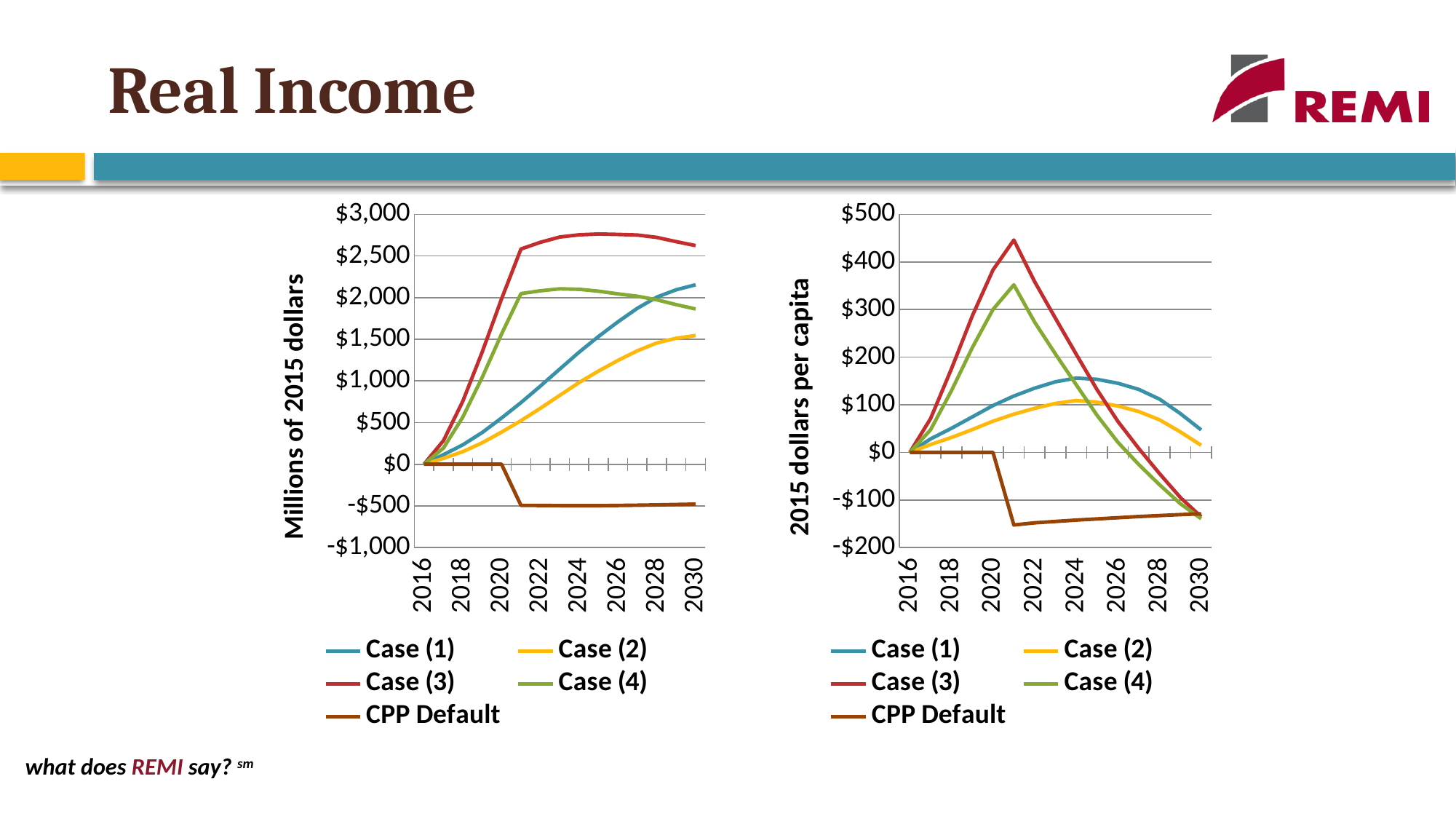
In the right chart (2015 dollars per capita), does Case (3) rise or fall from 2021 to 2030? Falls In the left chart (Millions of 2015 dollars), does Case (1) rise or fall from 2016 to 2030? Rises In the left chart (Millions of 2015 dollars), which series has the highest value in 2025? Case (3) What kind of chart is the left chart (Millions of 2015 dollars)? Line chart How many series does the legend of the right chart (2015 dollars per capita) list? 5 In the right chart (2015 dollars per capita), which series has the lowest value in 2022? CPP Default In the left chart (Millions of 2015 dollars), which is larger in 2030: Case (1) or Case (2)? Case (1) In the right chart (2015 dollars per capita), which series reaches the highest peak? Case (3) In the left chart (Millions of 2015 dollars), is the value for CPP Default in 2025 greater or less than $0? less In the left chart (Millions of 2015 dollars), is the value for Case (3) in 2025 greater or less than $2,500? greater What is the y-axis label of the right chart? 2015 dollars per capita In the right chart (2015 dollars per capita), is the value for Case (3) in 2021 greater or less than $400? greater